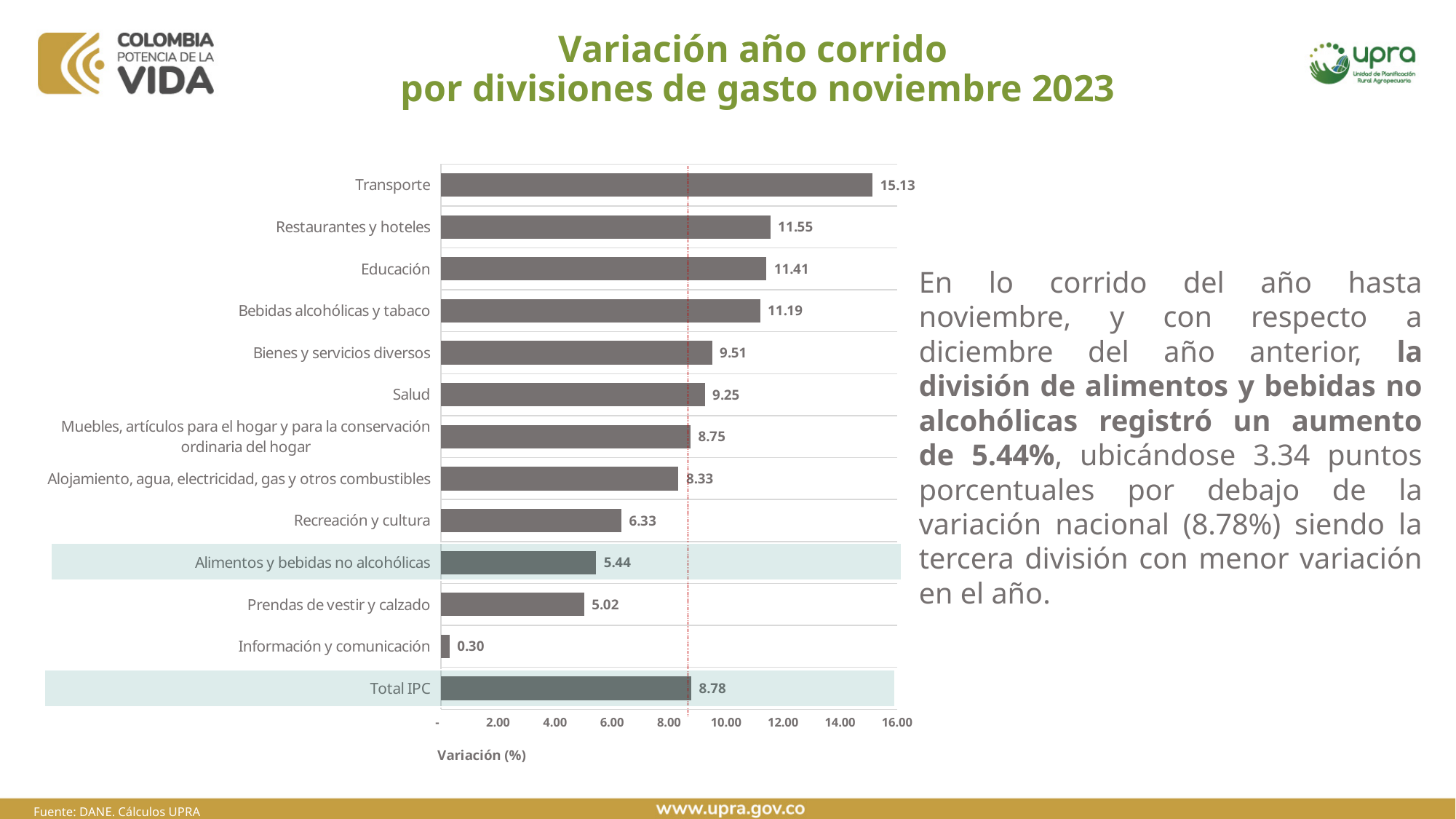
What is the difference between the value for Total IPC and the value for Alimentos y bebidas no alcohólicas? 3.34 Is the value for Recreación y cultura greater or less than 8.00? less What is the value for Alimentos y bebidas no alcohólicas? 5.44 Which is larger, the value for Salud or the value for Bienes y servicios diversos? Bienes y servicios diversos What is the difference between the values for Restaurantes y hoteles and Educación? 0.14 What is the label of the horizontal axis of the chart? Variación (%) What is the value for Transporte? 15.13 What kind of chart is shown on the slide? Bar chart Which division has the highest variation? Transporte How many bars are shown in the chart, including Total IPC? 13 Which division has the lowest variation? Información y comunicación What is the value for Total IPC? 8.78